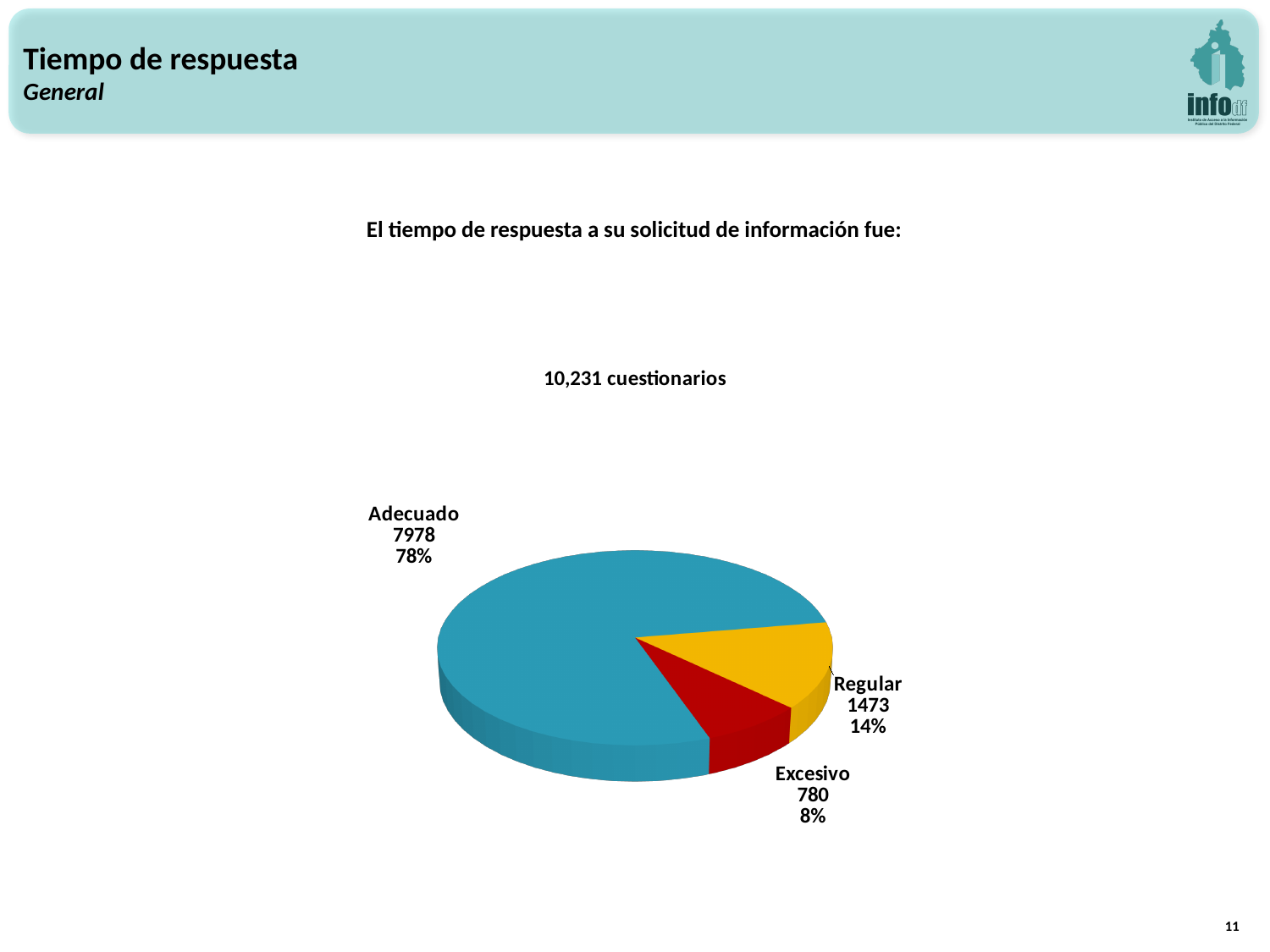
What kind of chart is shown on the slide? Pie chart What share of the pie does Regular represent? 14% What is the value for Regular? 1473 Which category has the largest slice? Adecuado What is the value for Excesivo? 780 Which is larger, the value for Regular or the value for Excesivo? Regular What is the difference between the values for Regular and Excesivo? 693 Which category has the smallest slice? Excesivo What share of the pie does Adecuado represent? 78% How many questionnaires does the slide say the chart is based on? 10,231 cuestionarios How many slices does the pie chart have? 3 What is the value for Adecuado? 7978